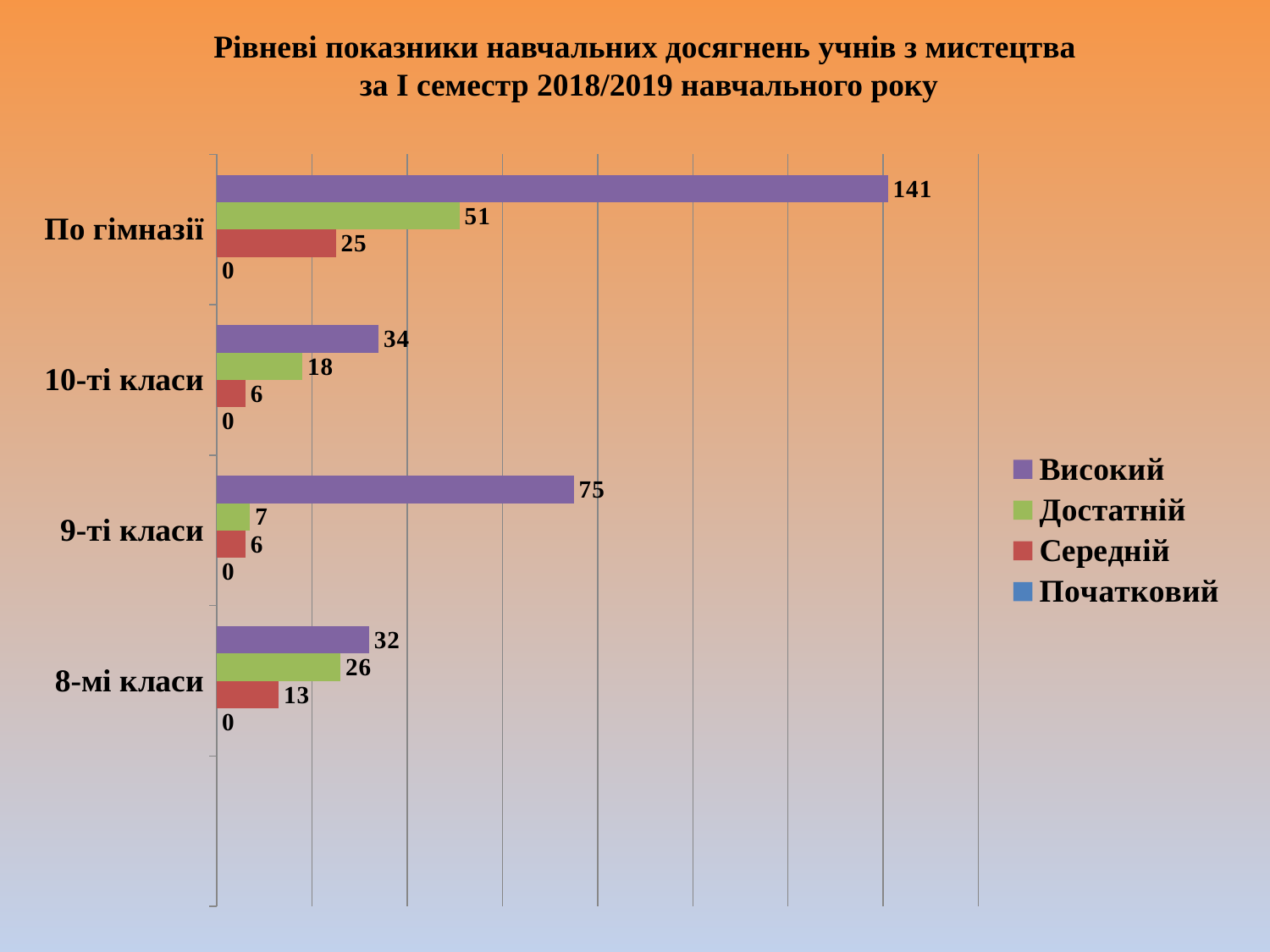
What is the total of Високий, Достатній, Середній and Початковий for 8-мі класи? 71 What is the value of Високий for По гімназії? 141 What is the difference between the Високий values for 9-ті класи and 10-ті класи? 41 What is the value of Достатній for 8-мі класи? 26 How many series does the legend list? 4 What is the value of Початковий for 9-ті класи? 0 Which category has the lowest Достатній value? 9-ті класи How many categories are shown on the chart? 4 What kind of chart is shown on the slide? bar chart Which is larger: Достатній for 10-ті класи or Достатній for 8-мі класи? Достатній for 8-мі класи Which category has the highest Високий value? По гімназії What is the value of Середній for 10-ті класи? 6